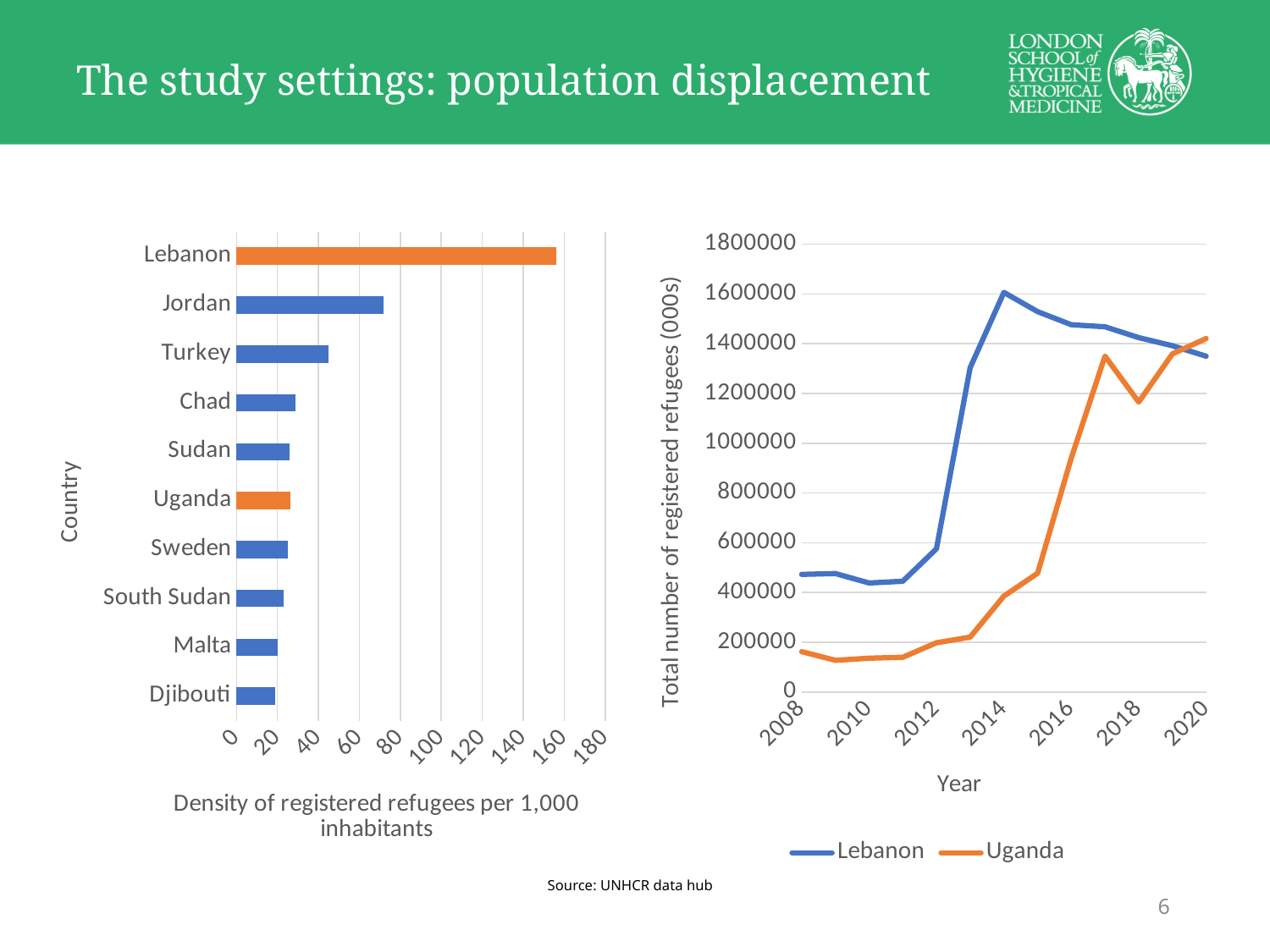
On the left chart, which country has the highest density of registered refugees per 1,000 inhabitants? Lebanon On the left chart, how many countries are shown? 10 On the right chart, does the Uganda line rise or fall between 2012 and 2017? Rise On the left chart, is the value for Malta greater or less than 40? less On the left chart, is the value for Jordan greater or less than 60? greater On the right chart, how many series does the legend list? 2 On the right chart, is the value for Uganda in 2008 greater or less than 400000? less On the left chart, which has a higher density of registered refugees, Jordan or Turkey? Jordan What kind of chart is the right chart? Line chart What kind of chart is the left chart? Bar chart